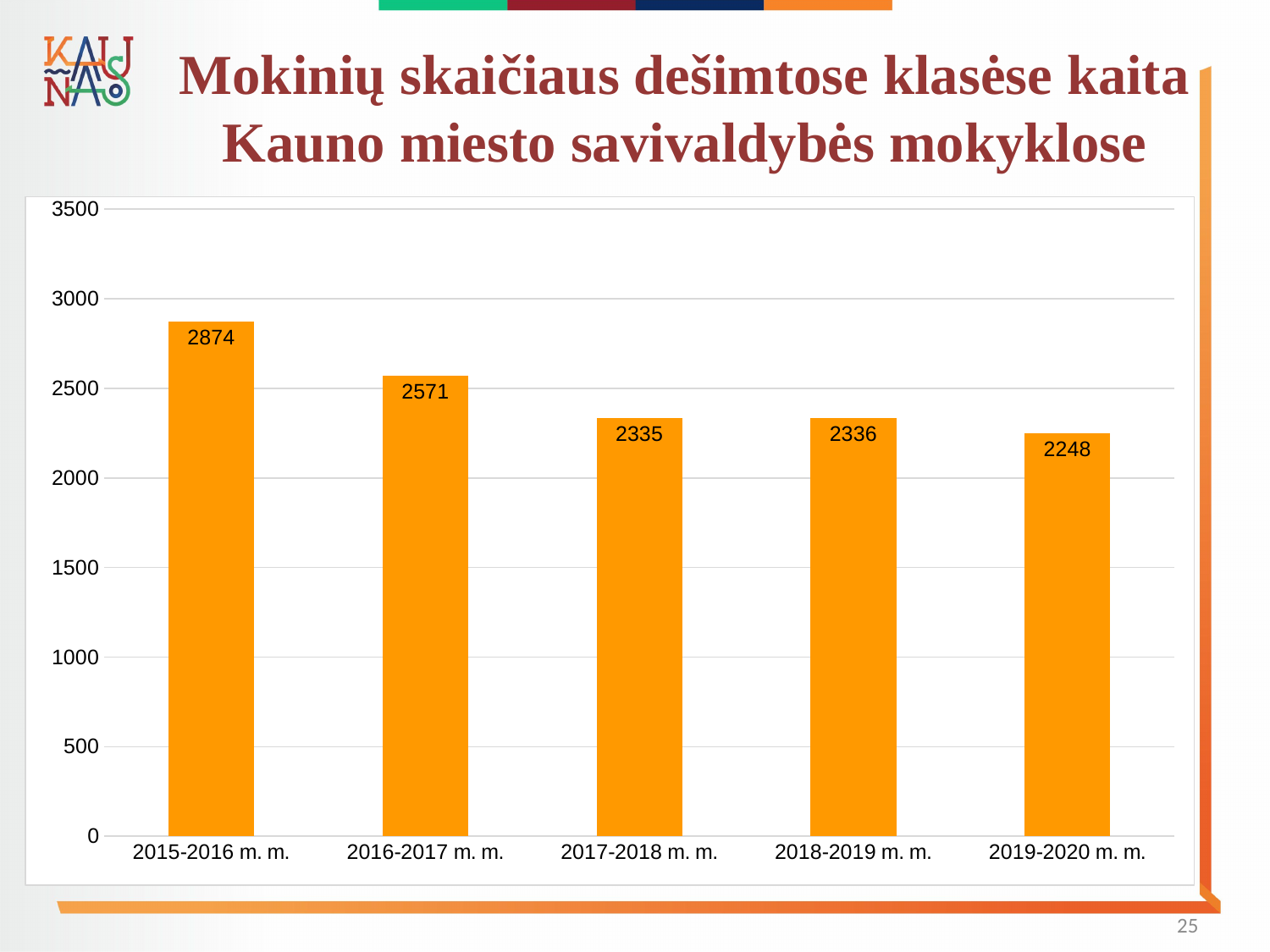
What is the value for 2017-2018 m. m.? 2335 Which school year has the highest value? 2015-2016 m. m. What kind of chart is shown on the slide? bar chart What is the value for 2019-2020 m. m.? 2248 Which school year has the lowest value? 2019-2020 m. m. What is the value for 2015-2016 m. m.? 2874 How many school years are shown on the x axis? 5 What is the difference between the values for 2018-2019 m. m. and 2019-2020 m. m.? 88 What is the difference between the values for 2015-2016 m. m. and 2016-2017 m. m.? 303 Do the values generally rise or fall from 2015-2016 m. m. to 2019-2020 m. m.? fall Is the value for 2016-2017 m. m. greater or less than 2500? greater Which is larger, the value for 2016-2017 m. m. or the value for 2019-2020 m. m.? 2016-2017 m. m.